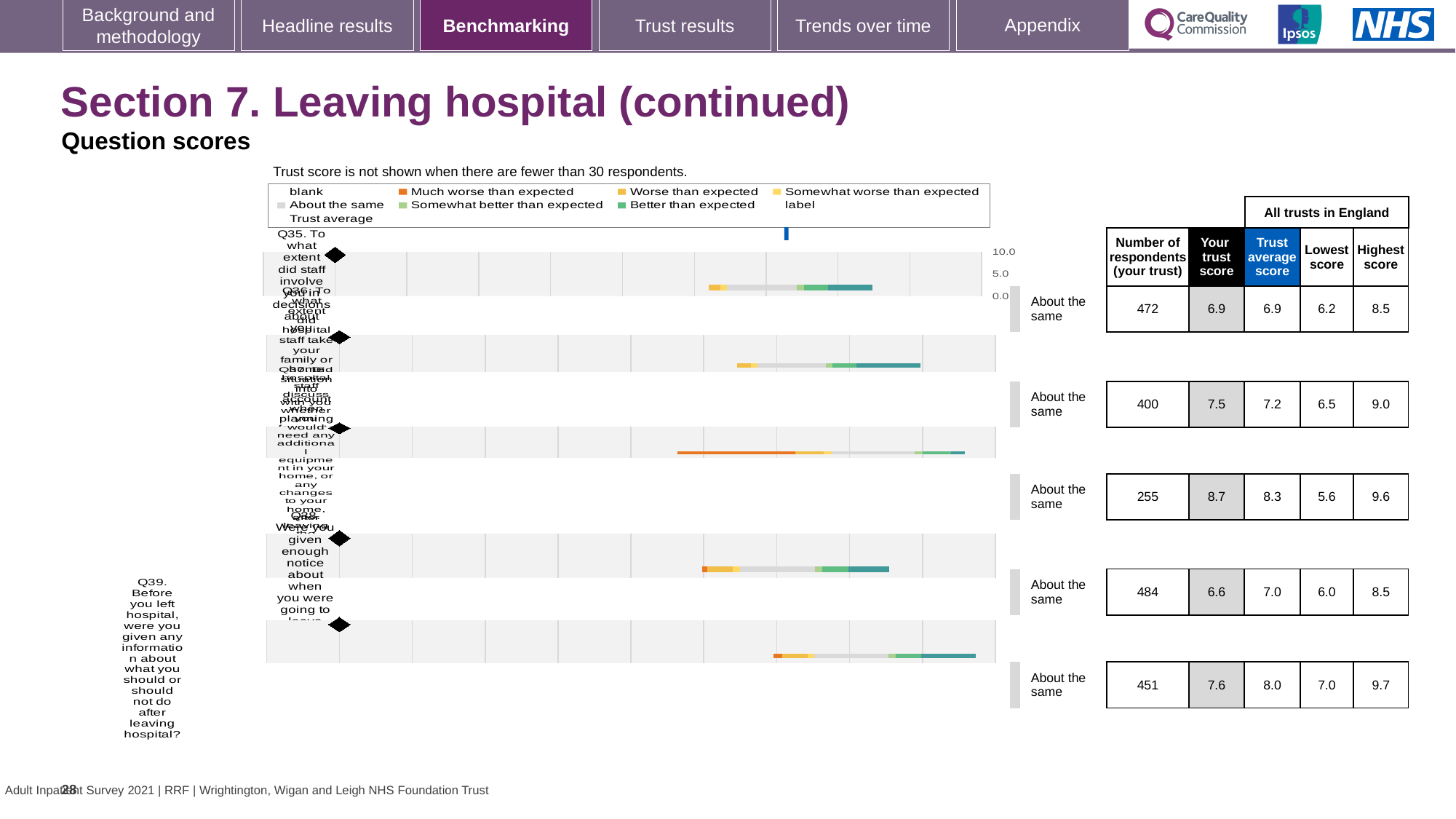
Which question row has the fewest respondents at this trust? Q37 (255) What is the trust score for Q39 (information about what you should or should not do after leaving hospital)? 7.6 What is the highest score across all trusts in England for Q39? 9.7 Is the trust score for Q38 higher or lower than the trust average score for Q38? lower What is the difference between the highest score and the lowest score for Q36 (family or home situation taken into account)? 2.5 Which question row has the highest 'Your trust score'? Q37 (8.7) What benchmark category is shown for every question on this slide? About the same What is the trust average score for Q38 (enough notice about when you were going to leave hospital)? 7.0 What kind of chart is used to show the question scores? bar chart How many question rows are plotted on the chart? 5 How many respondents answered Q35 (staff involving you in decisions about leaving hospital) at this trust? 472 What is the lowest score across all trusts in England for the third question row (Q37, additional equipment or changes to your home)? 5.6